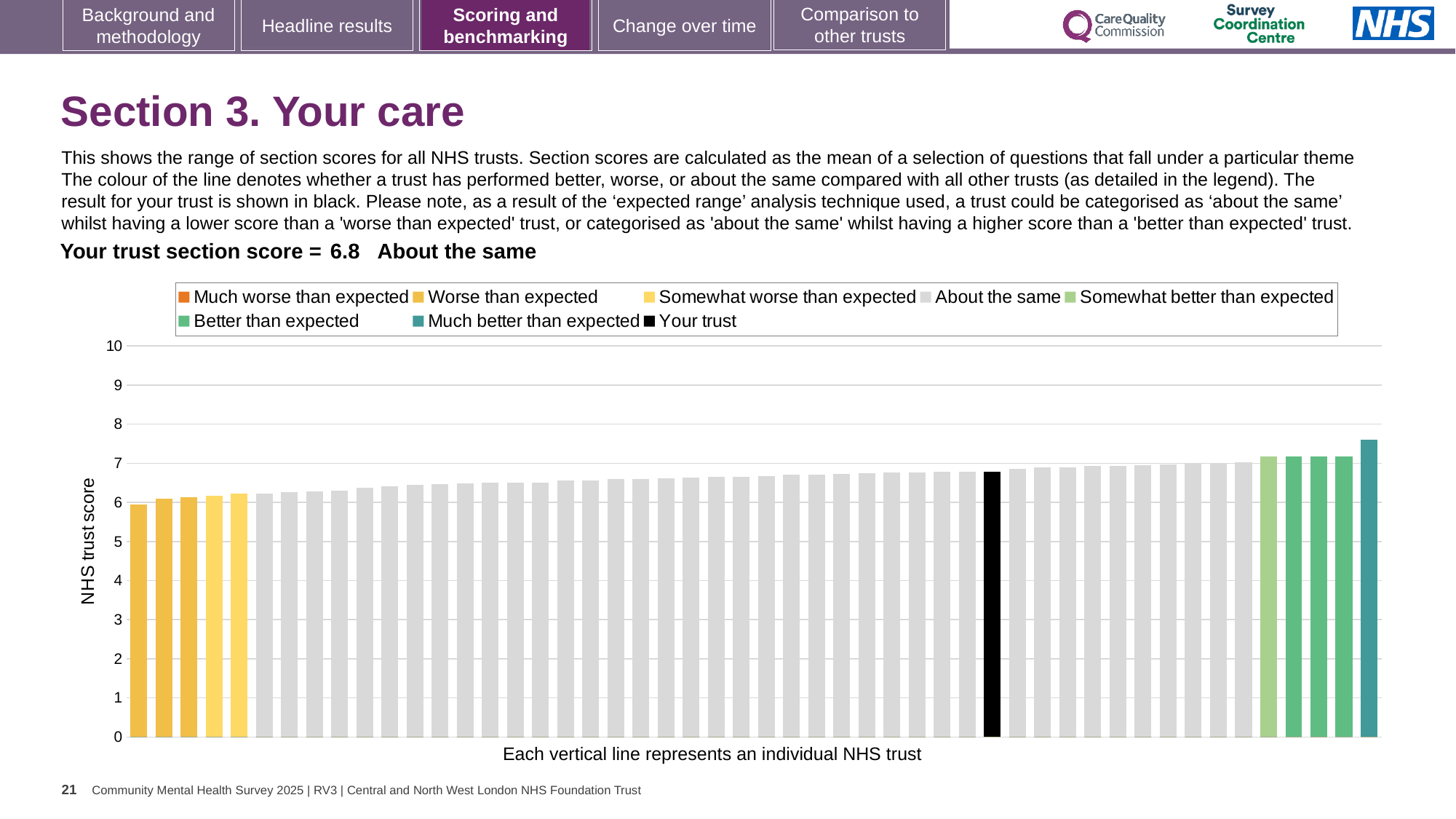
What is the section score for your trust shown on the slide? 6.8 Do the bar values rise or fall from left to right along the x axis? rise Is the value of the black 'Your trust' bar greater or less than 6? greater What kind of chart is shown on the slide? bar chart Is the value of the tallest bar on the chart greater or less than 7? greater Which legend category does the tallest bar on the chart belong to? Much better than expected Is the value of the leftmost bar on the chart greater or less than 5? greater How many bars are coloured as 'Much better than expected'? 1 How many categories does the chart legend list? 8 What is the label on the vertical axis of the chart? NHS trust score Which legend category is your trust placed in for this section? About the same Which is taller: the black 'Your trust' bar or the leftmost bar? the black 'Your trust' bar